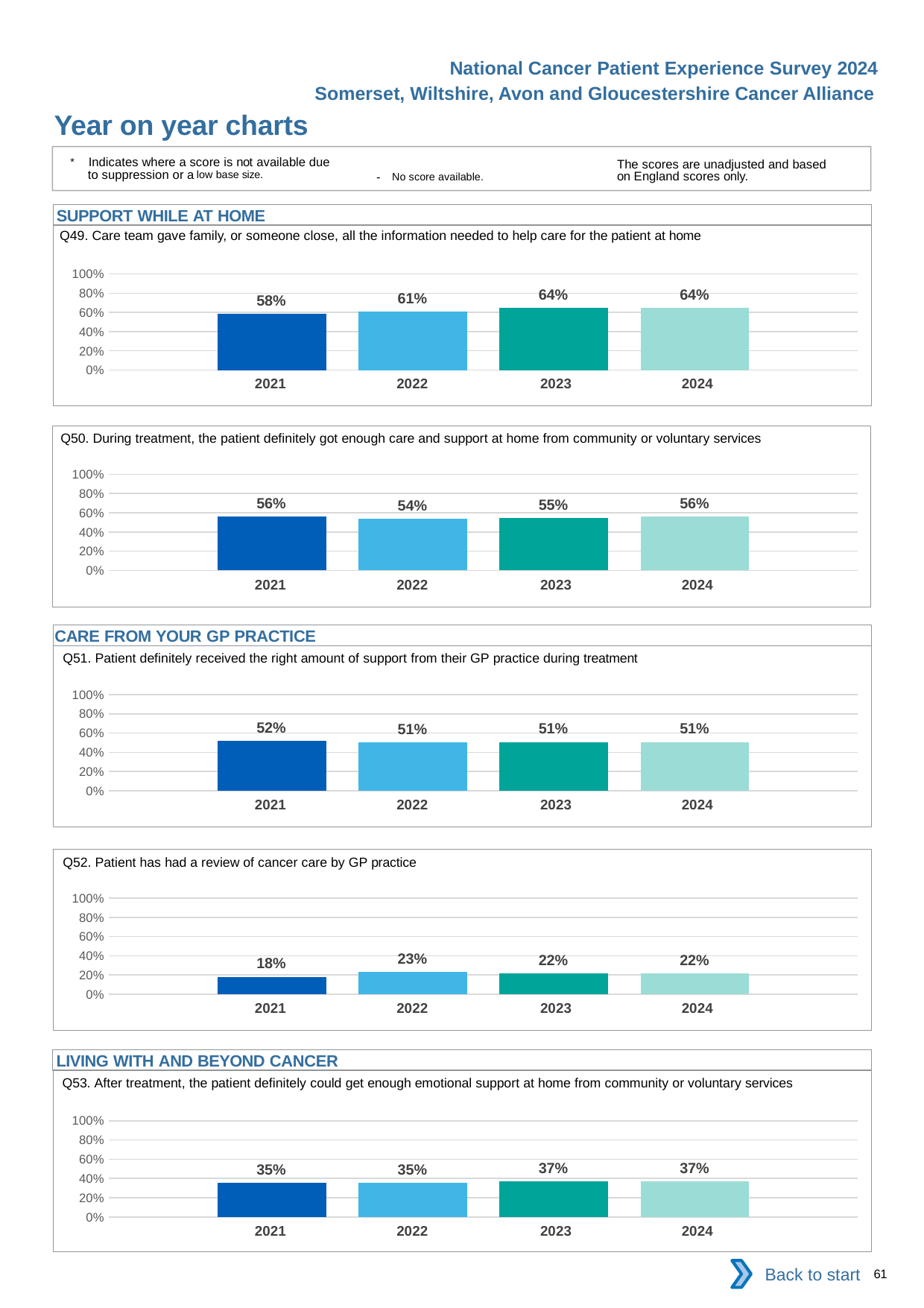
In the Q52 chart, which year has the highest value? 2022 In the Q51 chart, how many years are plotted? 4 In the Q49 chart, what is the value for 2021? 58% In the Q53 chart, is the value for 2023 larger than the value for 2022? Yes In the Q53 chart, what is the value for 2024? 37% In the Q52 chart, what is the difference between the 2022 and 2021 values? 5% In the Q50 chart, what is the difference between the 2021 and 2022 values? 2% In the Q51 chart, what is the value for 2021? 52% In the Q49 chart, which year has the lowest value? 2021 In the Q52 chart, is the value for 2021 greater or less than 20%? less In the Q50 chart, which year has the lowest value? 2022 What kind of chart is the Q53 chart? Bar chart